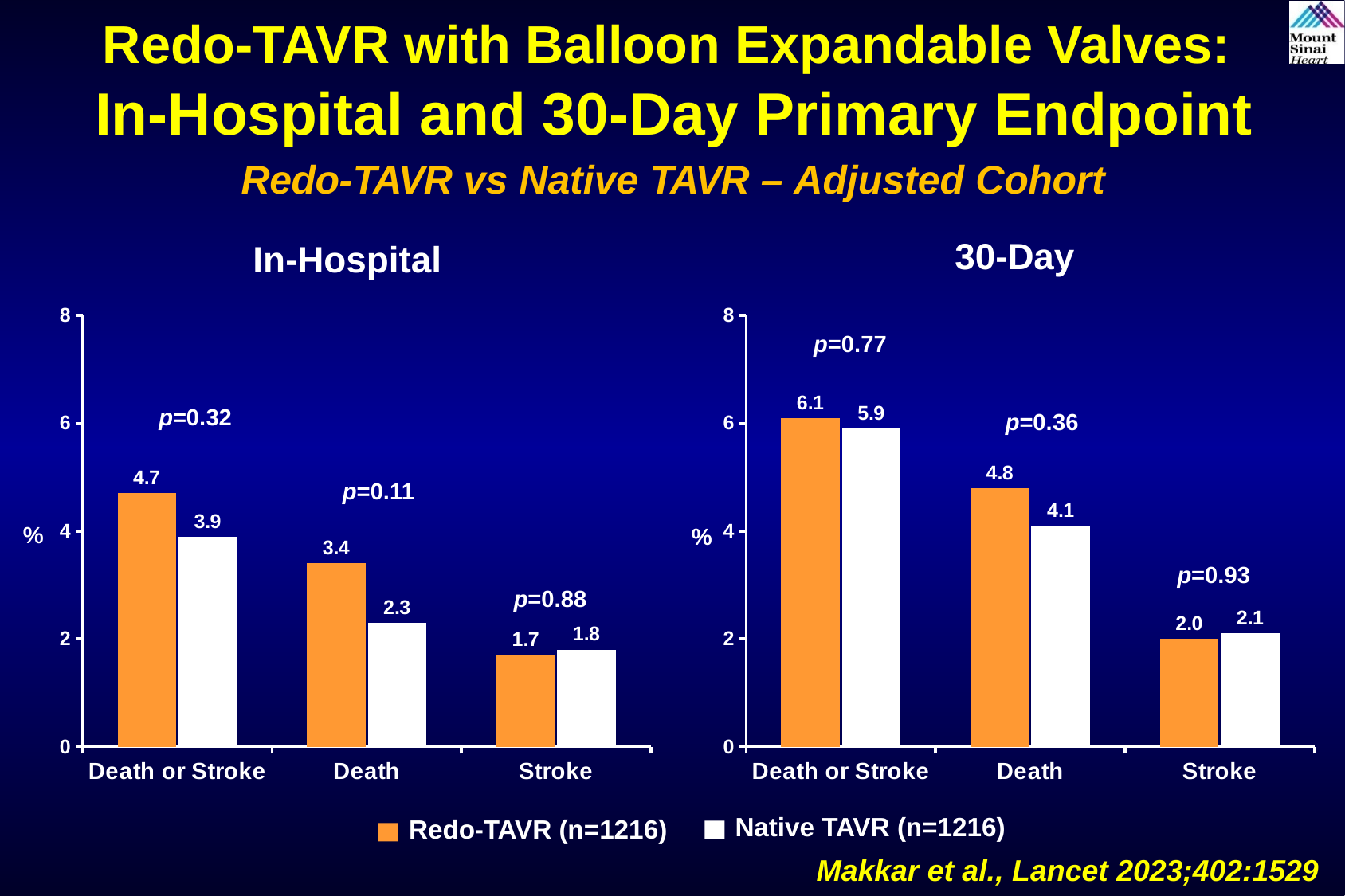
What kind of chart is the In-Hospital chart? Bar chart In the 30-Day chart, what is the difference between the Redo-TAVR and Native TAVR values for Death? 0.7 In the In-Hospital chart, what is the difference between the Redo-TAVR and Native TAVR values for Death? 1.1 In the In-Hospital chart, is the Redo-TAVR value for Death or Stroke greater or less than 4? greater In the 30-Day chart, what is the value for Native TAVR for Death? 4.1 How many series does the legend list? 2 How many categories are shown on the x axis of the 30-Day chart? 3 In the In-Hospital chart, what is the value for Native TAVR for Stroke? 1.8 In the 30-Day chart, which is larger for Death or Stroke: Redo-TAVR or Native TAVR? Redo-TAVR In the 30-Day chart, which category has the highest Redo-TAVR value? Death or Stroke In the In-Hospital chart, what is the value for Redo-TAVR for Death or Stroke? 4.7 In the In-Hospital chart, which category has the lowest Native TAVR value? Stroke